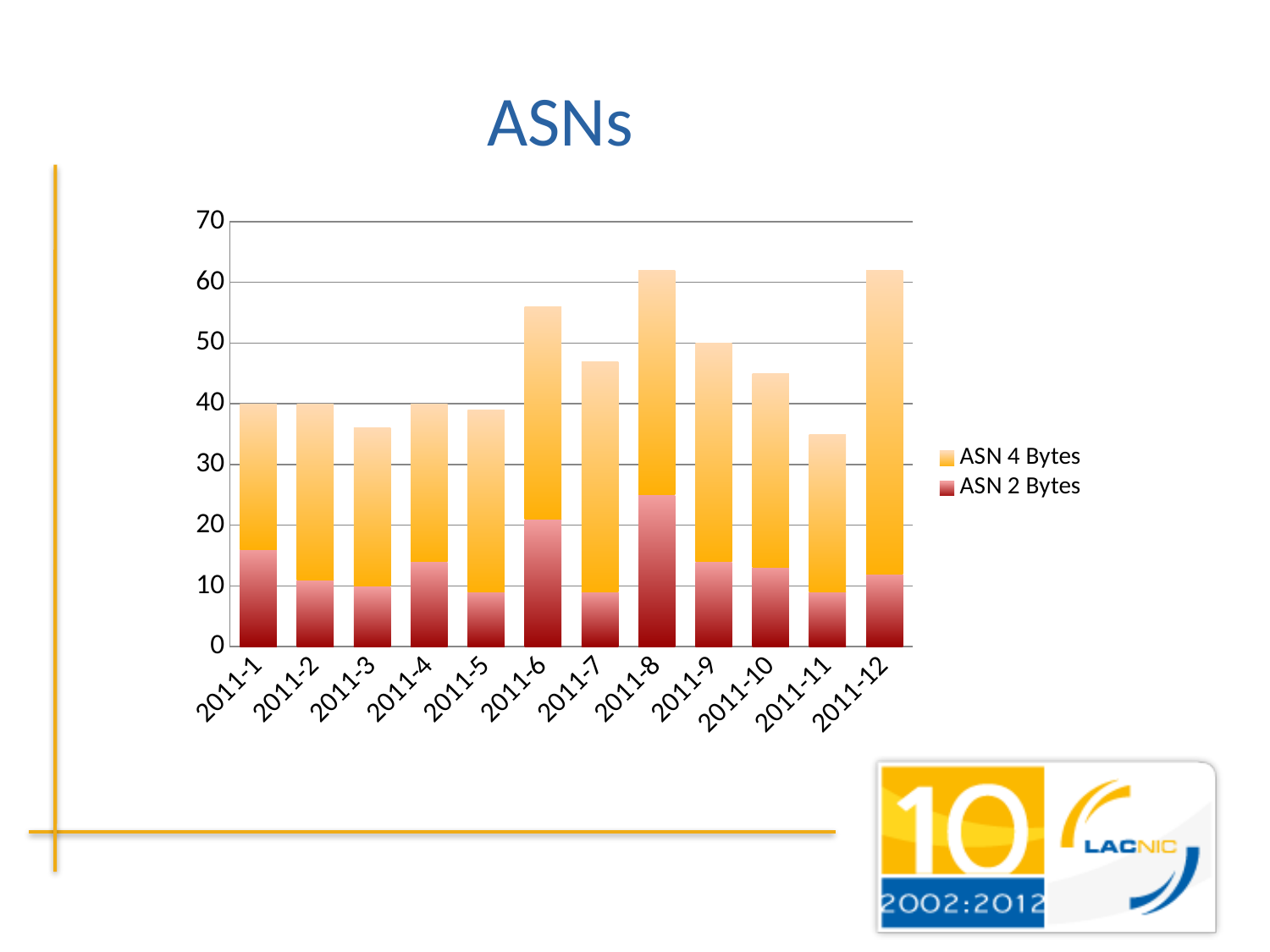
How many months (categories) are shown on the x axis? 12 What kind of chart is shown on the slide? bar chart Which two series are listed in the legend? ASN 4 Bytes and ASN 2 Bytes Is the total height of the bar for 2011-6 greater or less than 50? greater How many series does the legend list? 2 Is the total height of the bar for 2011-11 greater or less than 40? less Which has the taller total bar, 2011-8 or 2011-11? 2011-8 Which month has the highest ASN 2 Bytes value? 2011-8 Is the total height of the bar for 2011-3 greater or less than 40? less Which has the taller total bar, 2011-6 or 2011-7? 2011-6 What is the title of the chart? ASNs